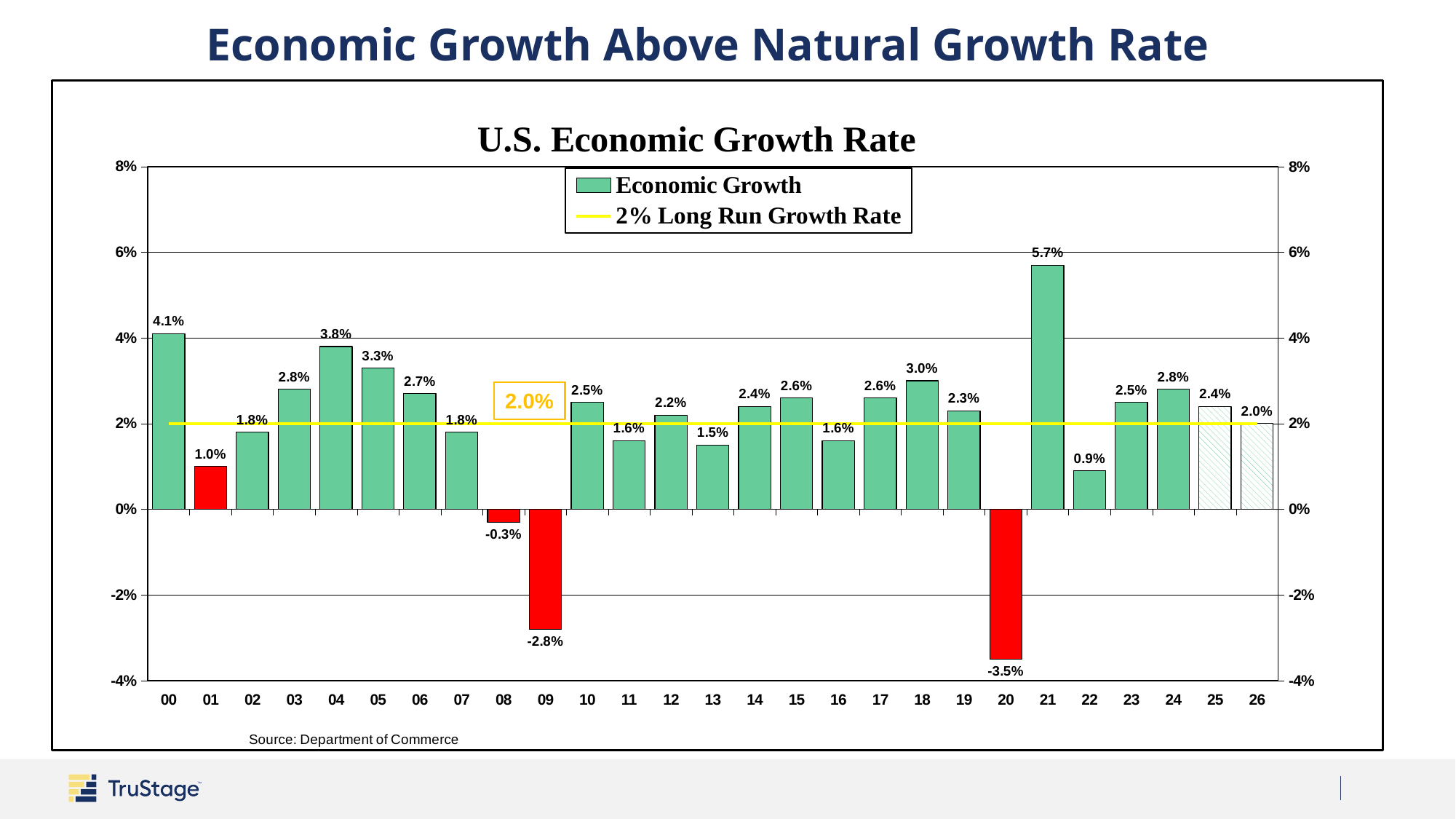
What is the difference between the economic growth rate in 21 and in 22? 4.8% What is the economic growth rate shown for 25? 2.4% What is the title of the chart? U.S. Economic Growth Rate How many years are shown on the x axis? 27 What is the economic growth rate shown for 21? 5.7% Which year has the lowest economic growth rate? 20 Is the economic growth rate for 00 greater or less than 4%? greater How many entries does the legend list? 2 Which year has the highest economic growth rate? 21 What is the economic growth rate shown for 09? -2.8% What kind of chart is used to show the economic growth rate? bar chart Which year has a higher economic growth rate, 04 or 18? 04